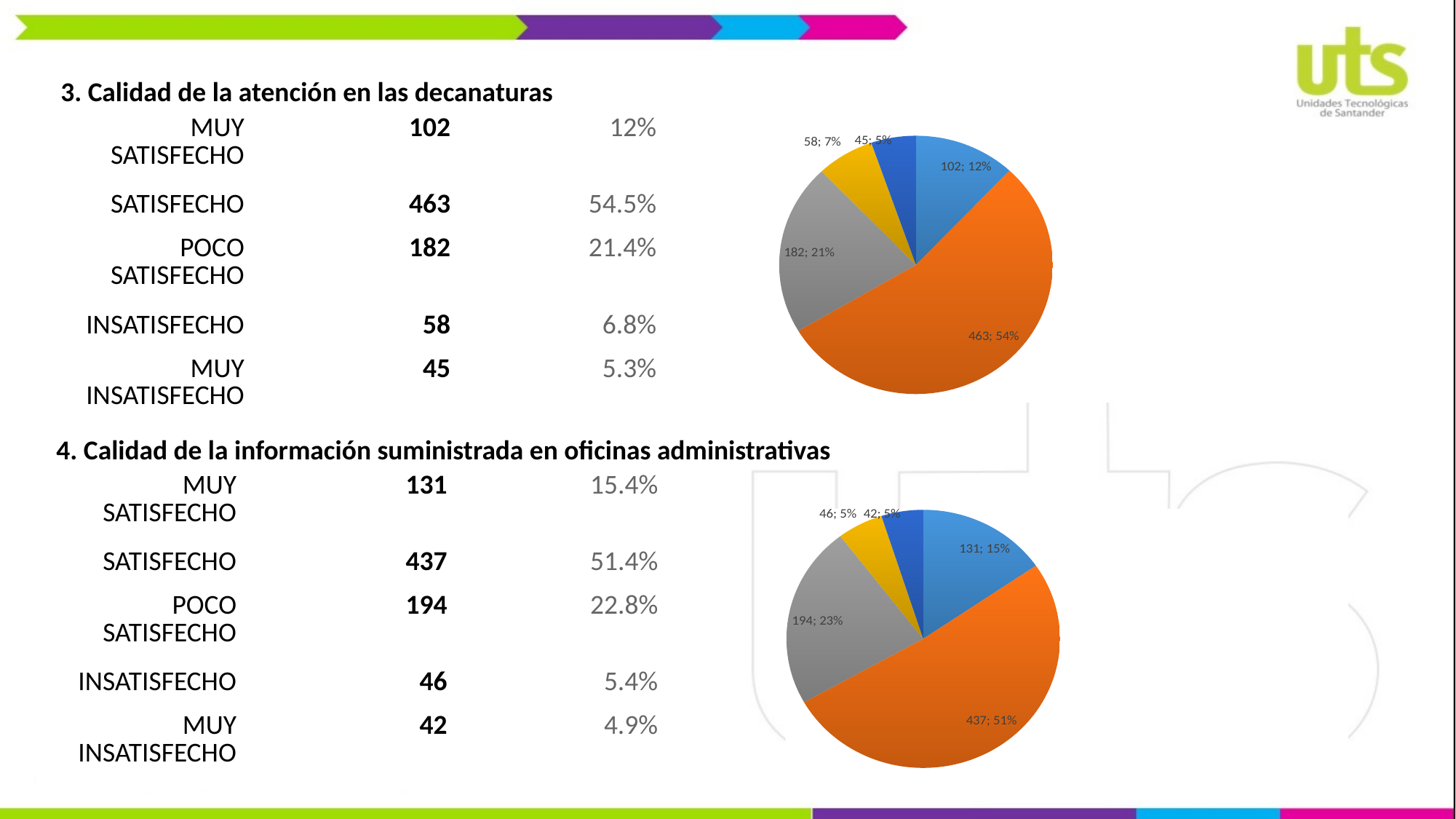
How many slices does the bottom pie chart (section 4) have? 5 In the top pie chart (section 3), what is the data label on the largest slice? 463; 54% In the bottom pie chart (section 4), what is the data label on the largest slice? 437; 51% In the top pie chart (section 3), what is the data label on the smallest slice? 45; 5% In the top pie chart (section 3), what percentage share is shown for the slice with value 182? 21% How many slices does the top pie chart (section 3) have? 5 In the top pie chart (section 3), what is the difference between the values of the largest slice (463) and the slice labelled 102? 361 What type of chart is shown next to section 3 (Calidad de la atención en las decanaturas)? pie chart In the bottom pie chart (section 4), what colour is the largest slice (437; 51%)? orange In the bottom pie chart (section 4), what percentage share is shown for the slice with value 131? 15% In the top pie chart (section 3), which slice is larger: the one labelled 58 or the one labelled 102? 102 In the bottom pie chart (section 4), what is the data label on the smallest slice? 42; 5%